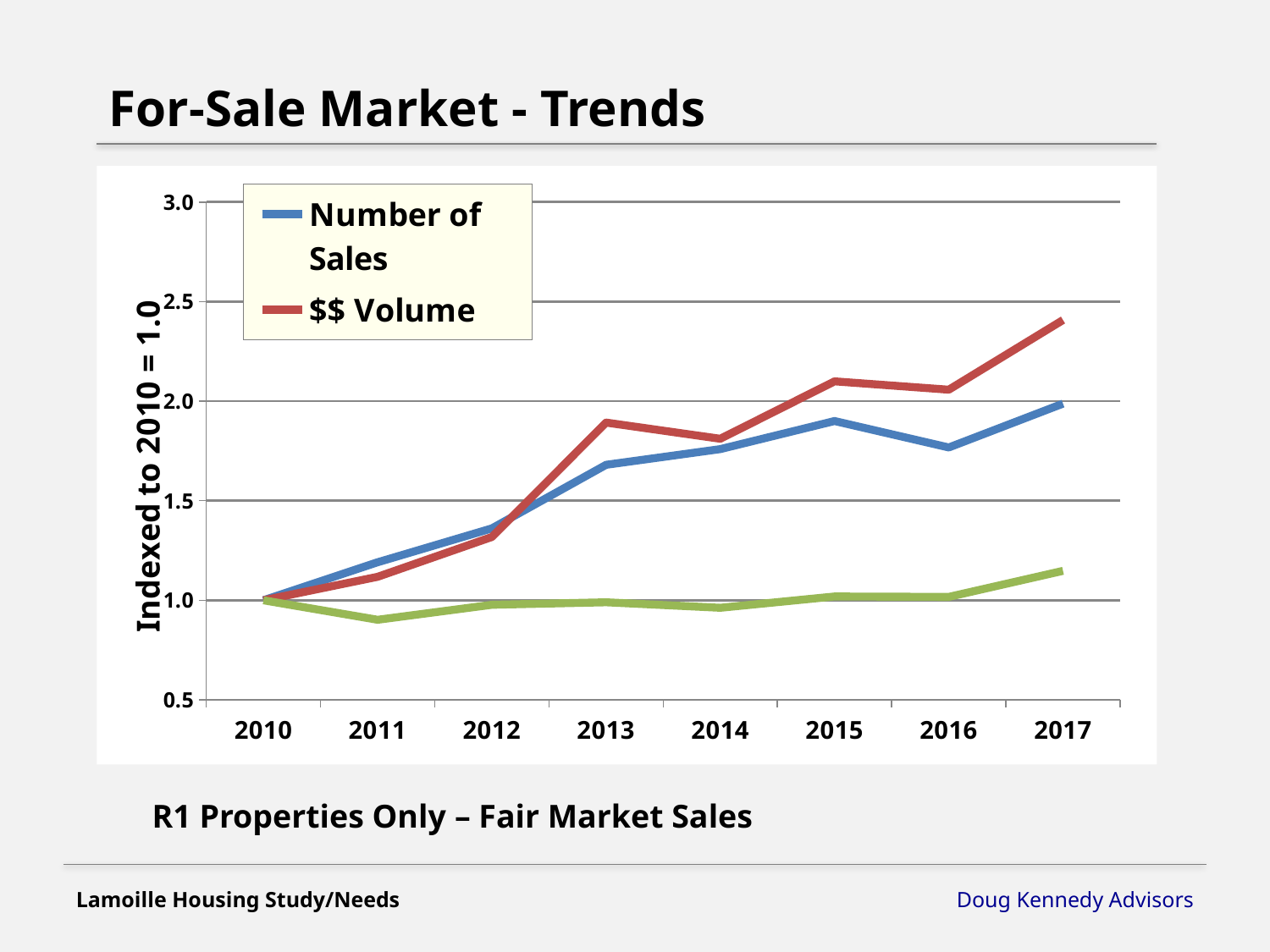
How many series does the legend list? 2 In 2017, which is larger: $$ Volume or Number of Sales? $$ Volume What kind of chart is shown on the slide? line chart How many years are shown along the x axis? 8 What is the value of Number of Sales in 2010? 1.0 Does $$ Volume rise or fall overall from 2010 to 2017? rise Is the value for Number of Sales in 2012 greater or less than 1.5? less What is the label on the y axis? Indexed to 2010 = 1.0 Is the value for $$ Volume in 2017 greater or less than 2.0? greater In which year is $$ Volume at its highest? 2017 Is the value for Number of Sales in 2013 greater or less than 1.5? greater In 2013, which is larger: $$ Volume or Number of Sales? $$ Volume